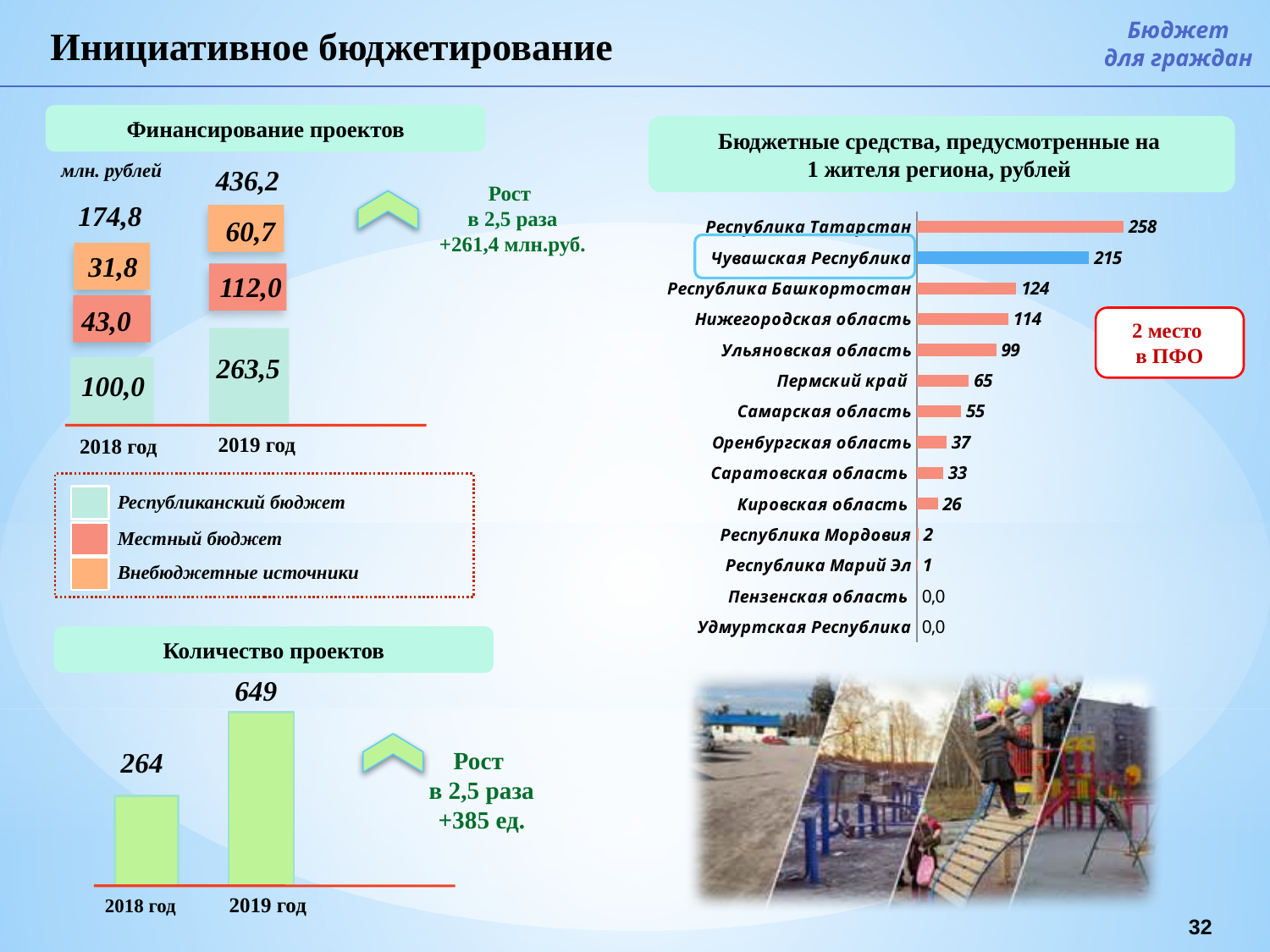
In the chart 'Бюджетные средства, предусмотренные на 1 жителя региона, рублей', what is the difference between Республика Татарстан and Чувашская Республика? 43 In the chart 'Количество проектов', what is the difference between 2019 год and 2018 год? 385 In the chart 'Бюджетные средства, предусмотренные на 1 жителя региона, рублей', which is larger: Нижегородская область or Ульяновская область? Нижегородская область In the chart 'Количество проектов', what is the value for 2019 год? 649 In the chart 'Финансирование проектов', what is the value of Местный бюджет for 2018 год? 43,0 How many regions are listed in the chart 'Бюджетные средства, предусмотренные на 1 жителя региона, рублей'? 14 In the chart 'Бюджетные средства, предусмотренные на 1 жителя региона, рублей', which region has the highest value? Республика Татарстан In the chart 'Бюджетные средства, предусмотренные на 1 жителя региона, рублей', what is the value for Чувашская Республика? 215 In the chart 'Финансирование проектов', what is the total for 2019 год? 436,2 In the chart 'Финансирование проектов', what is the value of Республиканский бюджет for 2019 год? 263,5 What type of chart is 'Бюджетные средства, предусмотренные на 1 жителя региона, рублей'? Bar chart How many series does the legend of the chart 'Финансирование проектов' list? 3